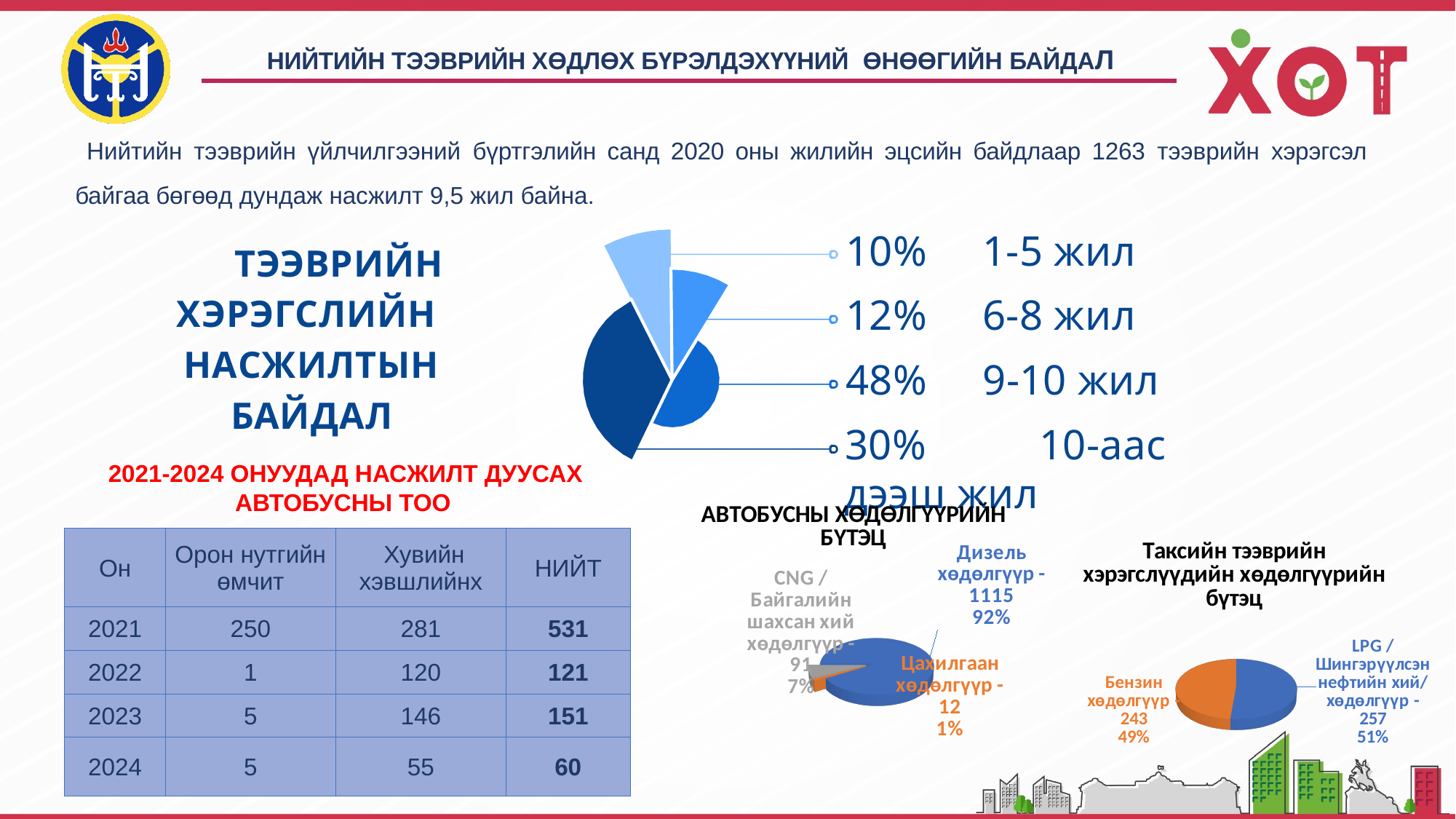
In the vehicle age pie chart, which age group has the smallest share? 1-5 жил In the АВТОБУСНЫ ХӨДӨЛГҮҮРИЙН БҮТЭЦ chart, what percentage of buses have a CNG / Байгалийн шахсан хий хөдөлгүүр? 7% In the АВТОБУСНЫ ХӨДӨЛГҮҮРИЙН БҮТЭЦ chart, which engine type has the fewest buses? Цахилгаан хөдөлгүүр In the vehicle age pie chart, how many age groups are shown? 4 In the АВТОБУСНЫ ХӨДӨЛГҮҮРИЙН БҮТЭЦ chart, how many buses have a Дизель хөдөлгүүр? 1115 In the vehicle age pie chart, what share of vehicles are 1-5 жил old? 10% In the vehicle age pie chart, which age group has the largest share? 9-10 жил In the Таксийн тээврийн хэрэгслүүдийн хөдөлгүүрийн бүтэц chart, which is larger: Бензин хөдөлгүүр or LPG хөдөлгүүр? LPG хөдөлгүүр What kind of chart is the АВТОБУСНЫ ХӨДӨЛГҮҮРИЙН БҮТЭЦ chart? Pie chart In the vehicle age pie chart, what is the difference in percentage points between the 9-10 жил and 10-аас дээш жил groups? 18 In the Таксийн тээврийн хэрэгслүүдийн хөдөлгүүрийн бүтэц chart, how many taxis have an LPG / Шингэрүүлсэн нефтийн хий хөдөлгүүр? 257 In the vehicle age pie chart (ТЭЭВРИЙН ХЭРЭГСЛИЙН НАСЖИЛТЫН БАЙДАЛ), what share of vehicles are 9-10 жил old? 48%